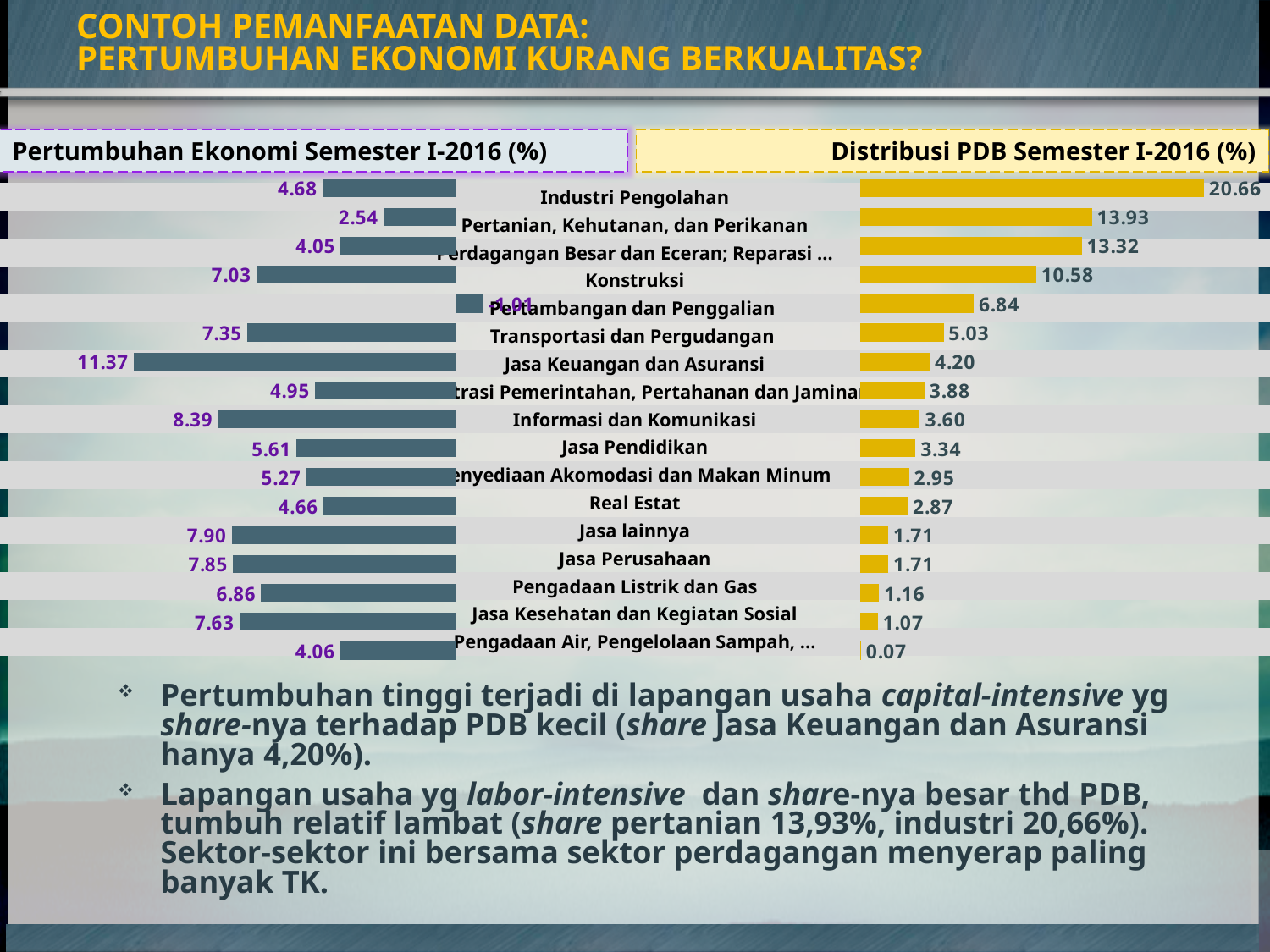
In the Pertumbuhan Ekonomi Semester I-2016 (%) chart, which is larger: Jasa Pendidikan or Real Estat? Jasa Pendidikan In the Pertumbuhan Ekonomi Semester I-2016 (%) chart, what is the value for Konstruksi? 7.03 In the Distribusi PDB Semester I-2016 (%) chart, which category has the lowest value? Pengadaan Air, Pengelolaan Sampah, ... In the Distribusi PDB Semester I-2016 (%) chart, what is the value for Industri Pengolahan? 20.66 In the Distribusi PDB Semester I-2016 (%) chart, what is the difference between Industri Pengolahan and Pertanian, Kehutanan, dan Perikanan? 6.73 In the Pertumbuhan Ekonomi Semester I-2016 (%) chart, what is the difference between Jasa Keuangan dan Asuransi and Informasi dan Komunikasi? 2.98 In the Pertumbuhan Ekonomi Semester I-2016 (%) chart, what is the value for Jasa Keuangan dan Asuransi? 11.37 In the Distribusi PDB Semester I-2016 (%) chart, what is the value for Pertanian, Kehutanan, dan Perikanan? 13.93 What kind of chart is the Distribusi PDB Semester I-2016 (%) chart? Bar chart How many categories are shown in the Distribusi PDB Semester I-2016 (%) chart? 17 In the Distribusi PDB Semester I-2016 (%) chart, which category has the highest value? Industri Pengolahan In the Pertumbuhan Ekonomi Semester I-2016 (%) chart, which category has the highest value? Jasa Keuangan dan Asuransi